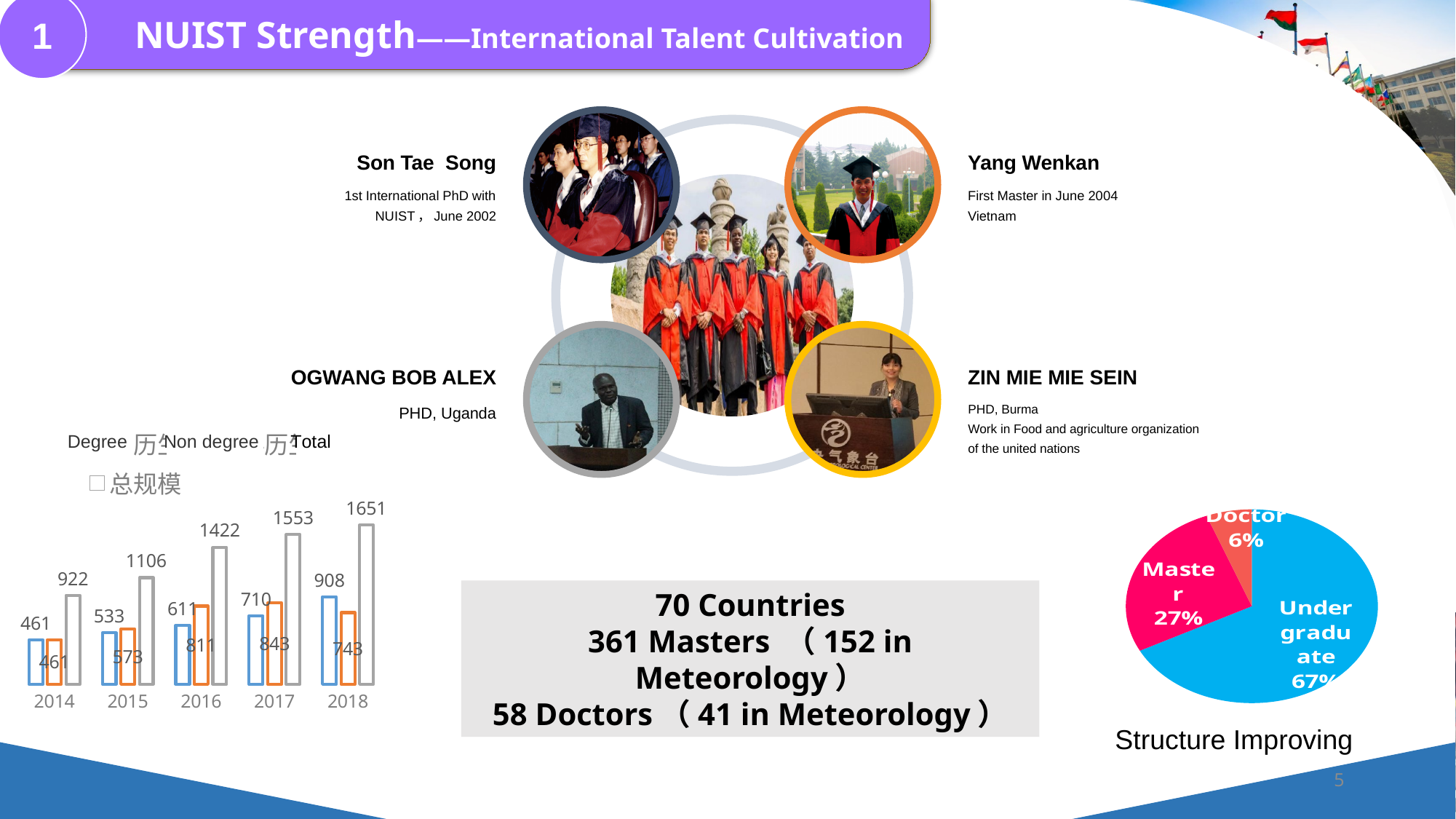
In the bar chart at the bottom left, does the Total value rise or fall from 2014 to 2018? rise In the bar chart at the bottom left, what is the Degree value for 2017? 710 In the pie chart at the bottom right, what share does Master have? 27% In the bar chart at the bottom left, which year has the lowest Degree value? 2014 In the bar chart at the bottom left, what is the Total value for 2018? 1651 In the bar chart at the bottom left, what is the Non degree value for 2016? 811 What kind of chart is shown at the bottom right of the slide? pie chart In the bar chart at the bottom left, which is larger in 2018, the Degree value or the Non degree value? Degree In the bar chart at the bottom left, which year has the highest Total value? 2018 In the bar chart at the bottom left, what is the difference between the Total values for 2018 and 2017? 98 In the pie chart at the bottom right, which category has the smallest slice? Doctor In the bar chart at the bottom left, how many years are shown on the x axis? 5